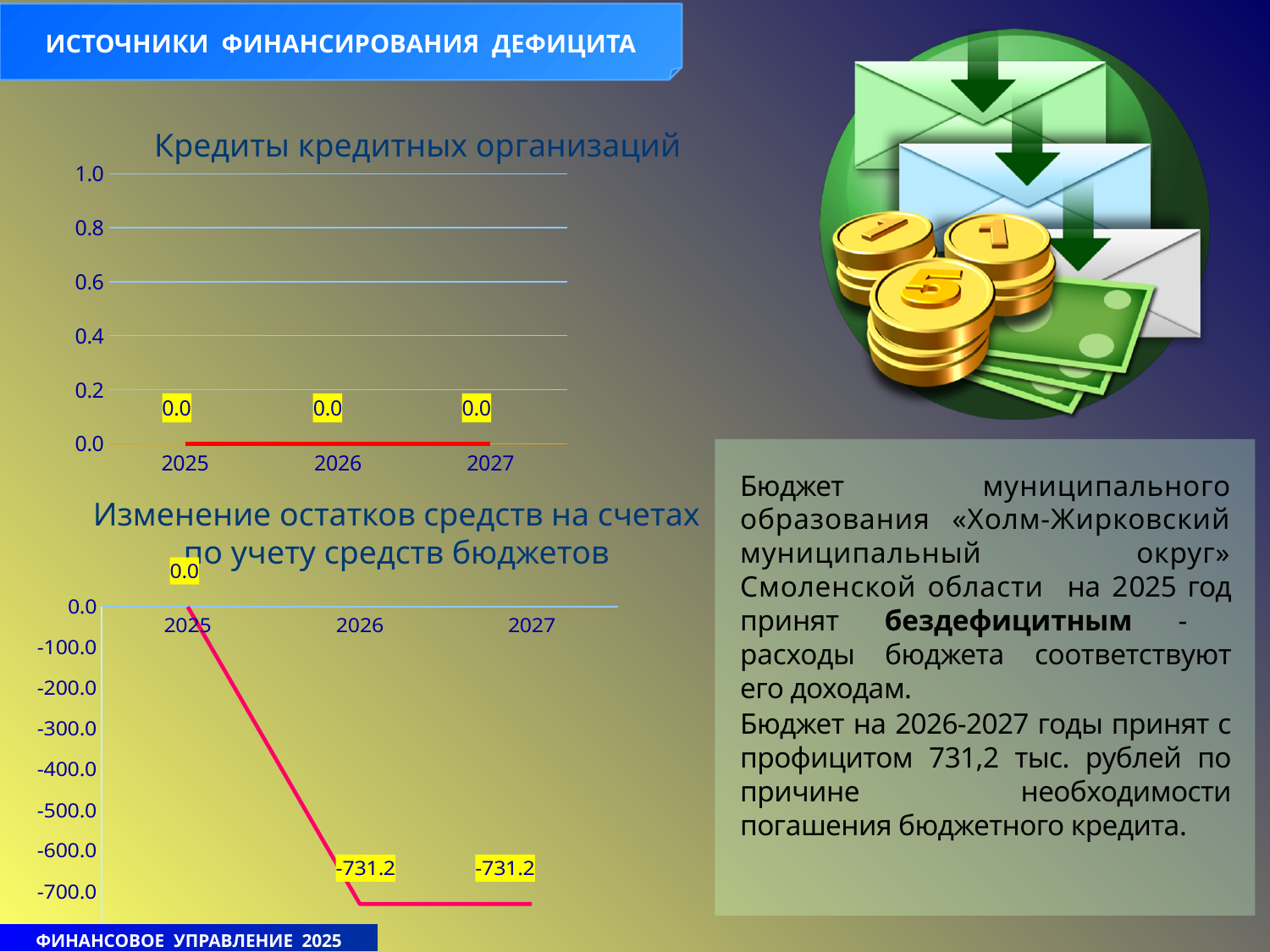
In the chart 'Кредиты кредитных организаций', what is the value for 2026? 0.0 In the chart 'Кредиты кредитных организаций', do the values rise, fall or stay flat from 2025 to 2027? stay flat In the chart 'Изменение остатков средств на счетах по учету средств бюджетов', what is the value for 2026? -731.2 In the chart 'Изменение остатков средств на счетах по учету средств бюджетов', which year has the highest value? 2025 In the chart 'Изменение остатков средств на счетах по учету средств бюджетов', is the value for 2026 greater or less than -500.0? less In the chart 'Изменение остатков средств на счетах по учету средств бюджетов', do the values rise or fall from 2025 to 2026? fall In the chart 'Кредиты кредитных организаций', how many years are plotted on the x axis? 3 What kind of chart is 'Кредиты кредитных организаций'? line chart In the chart 'Изменение остатков средств на счетах по учету средств бюджетов', what is the value for 2025? 0.0 What is the title of the upper chart on the slide? Кредиты кредитных организаций In the chart 'Изменение остатков средств на счетах по учету средств бюджетов', what is the value for 2027? -731.2 In the chart 'Изменение остатков средств на счетах по учету средств бюджетов', what is the difference between the values for 2025 and 2026? 731.2